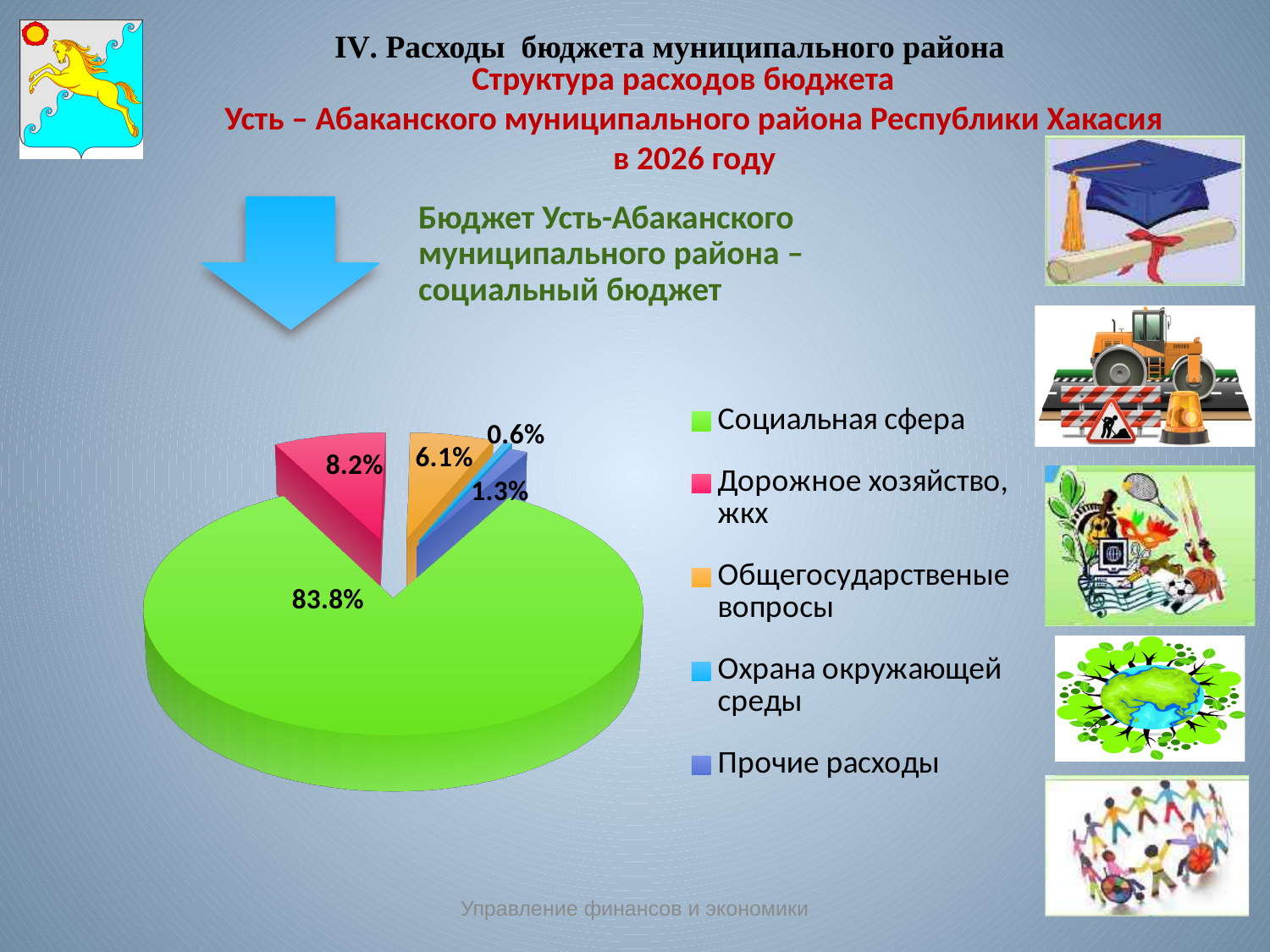
Which category has the largest slice of the pie? Социальная сфера What is the value shown for "Дорожное хозяйство, жкх"? 8.2% How many categories does the pie chart have? 5 What colour is the slice for "Дорожное хозяйство, жкх"? pink/red Which is larger: "Прочие расходы" or "Охрана окружающей среды"? Прочие расходы Which category has the smallest slice of the pie? Охрана окружающей среды What is the value shown for "Охрана окружающей среды"? 0.6% What share of the pie does "Социальная сфера" have? 83.8% What is the value shown for "Прочие расходы"? 1.3% What is the value shown for "Общегосударственые вопросы"? 6.1% What kind of chart is shown on the slide? pie chart What is the difference between the values for "Дорожное хозяйство, жкх" and "Общегосударственые вопросы"? 2.1%